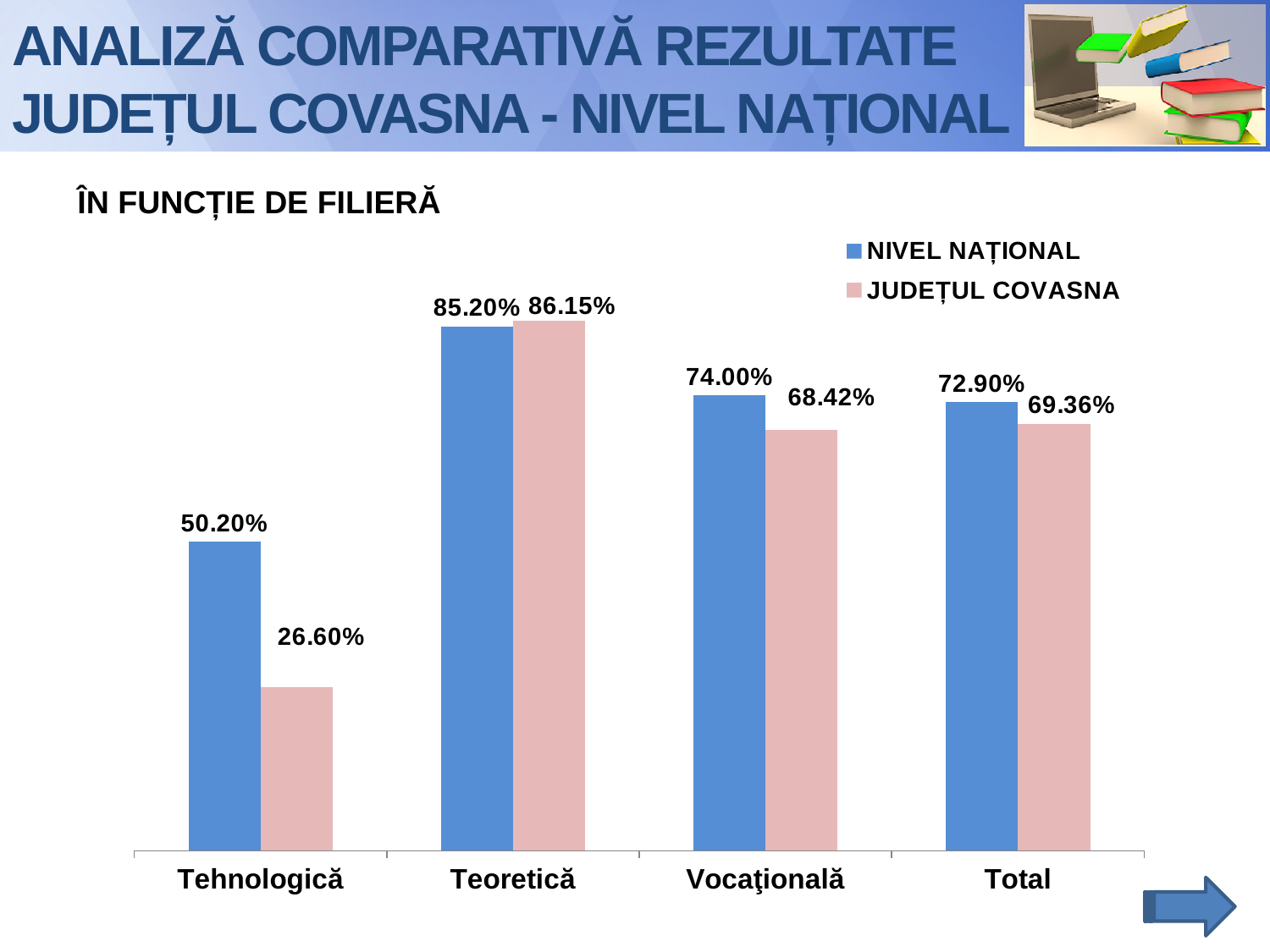
What is the difference between the NIVEL NAȚIONAL and JUDEȚUL COVASNA values for Tehnologică? 23.60% For Vocaţională, which is larger: NIVEL NAȚIONAL or JUDEȚUL COVASNA? NIVEL NAȚIONAL Which category has the lowest NIVEL NAȚIONAL value? Tehnologică What is the JUDEȚUL COVASNA value for Tehnologică? 26.60% What kind of chart is shown on the slide? Bar chart Which category has the highest JUDEȚUL COVASNA value? Teoretică What is the NIVEL NAȚIONAL value for Tehnologică? 50.20% What is the JUDEȚUL COVASNA value for Total? 69.36% What is the JUDEȚUL COVASNA value for Teoretică? 86.15% How many series does the legend list? 2 What is the NIVEL NAȚIONAL value for Vocaţională? 74.00% How many categories are shown on the x axis? 4